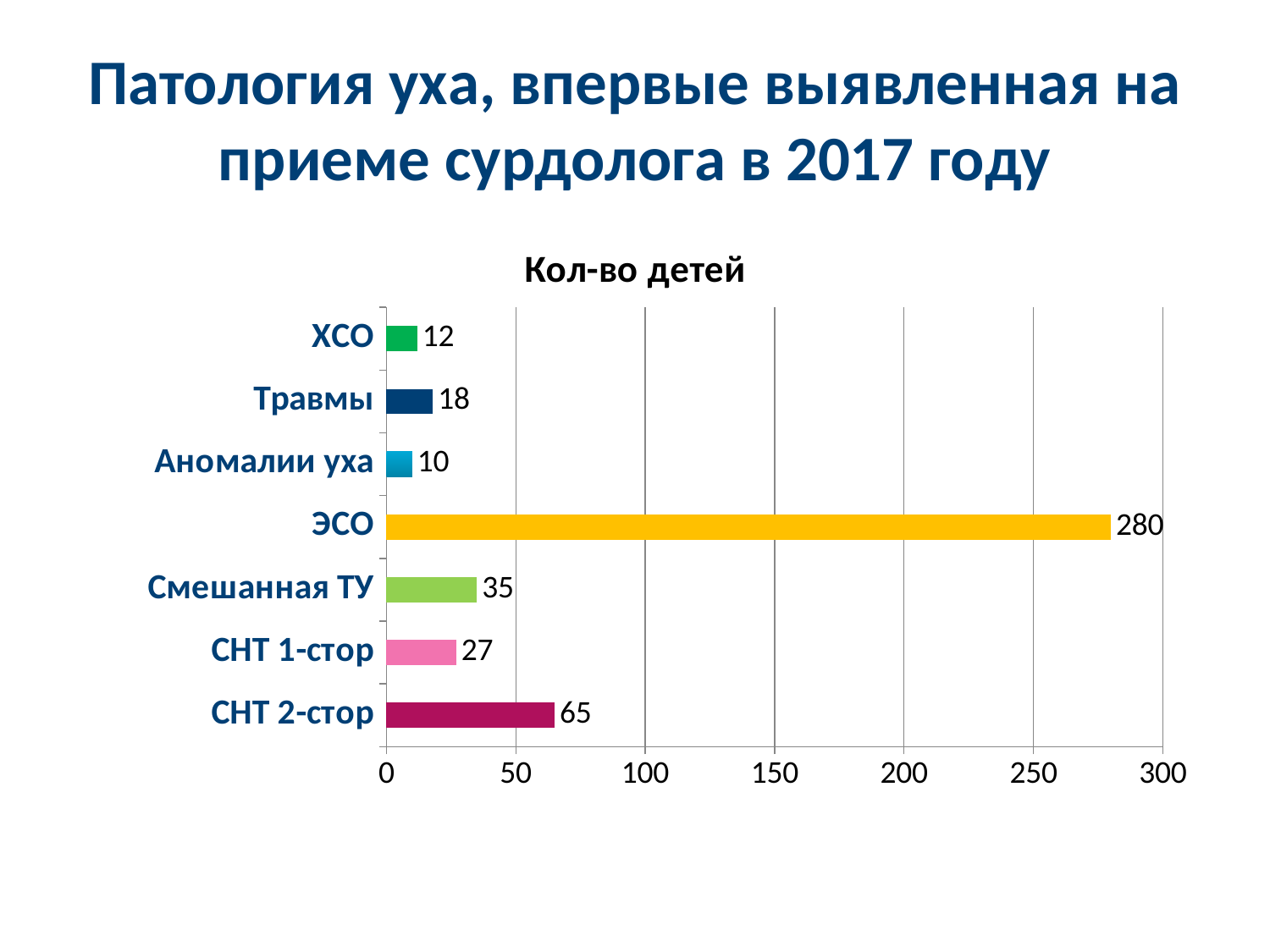
Which is larger, the value for Травмы or the value for ХСО? Травмы What is the difference between the values for Смешанная ТУ and СНТ 1-стор? 8 What is the value for ЭСО? 280 Which category has the lowest value? Аномалии уха How many categories are shown in the chart? 7 What is the difference between the values for ЭСО and СНТ 2-стор? 215 Which category has the highest value? ЭСО What is the title of the chart? Кол-во детей Is the value for СНТ 2-стор greater or less than 50? greater What is the value for СНТ 2-стор? 65 What is the value for Аномалии уха? 10 What kind of chart is shown on the slide? bar chart